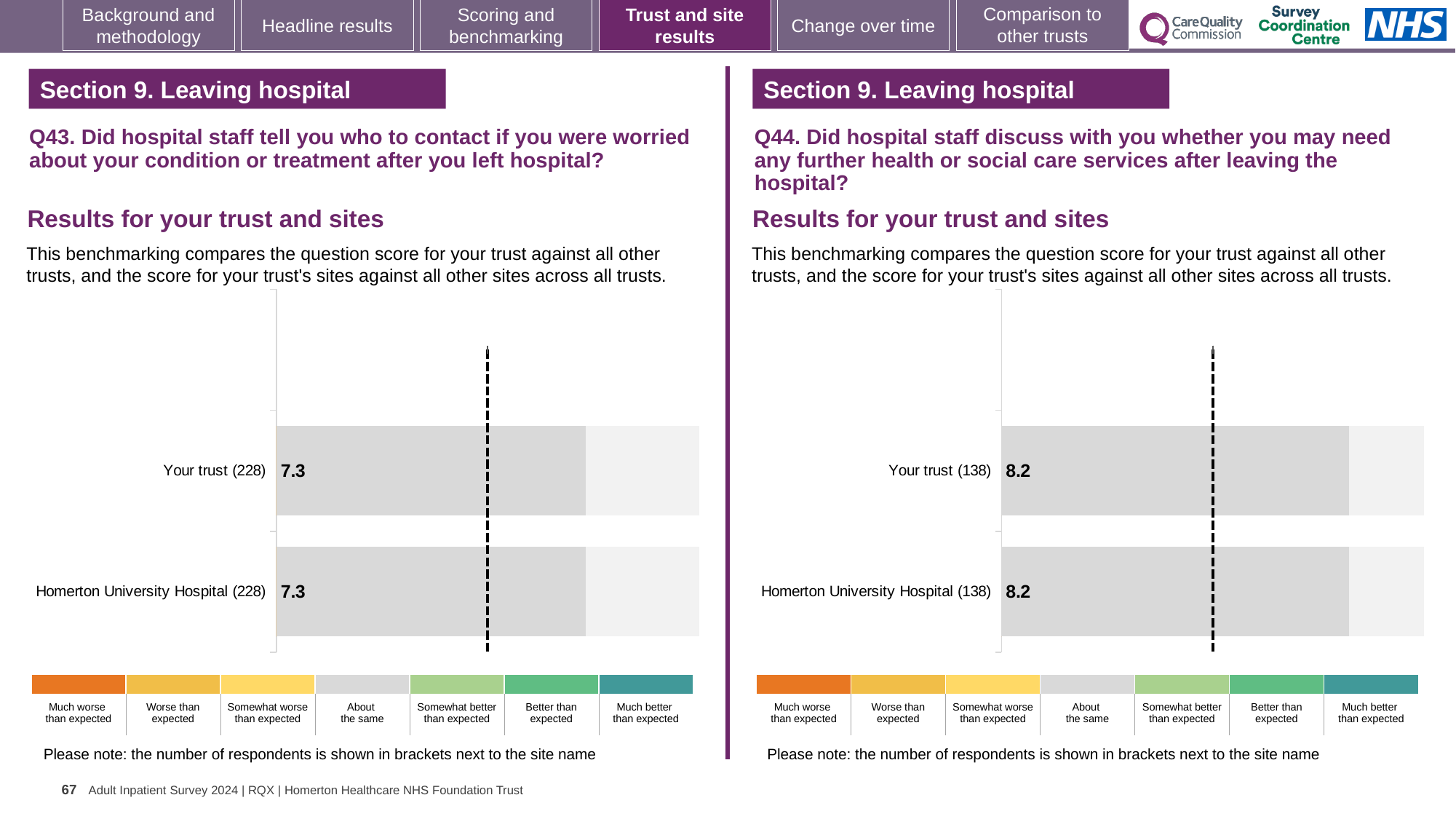
How many bars are plotted in the Q43 chart on the left? 2 In the Q43 chart on the left, how many respondents are shown in brackets for Your trust? 228 What is the label of the middle category in the colour key below the Q44 chart on the right? About the same In the Q44 chart on the right, what is the score for Your trust? 8.2 In the Q43 chart on the left, what is the score for Homerton University Hospital? 7.3 In the Q43 chart on the left, what is the difference between the score for Your trust and the score for Homerton University Hospital? 0 In the Q44 chart on the right, how many respondents are shown in brackets for Homerton University Hospital? 138 In the Q43 chart on the left, what is the score for Your trust? 7.3 In the Q44 chart on the right, what is the score for Homerton University Hospital? 8.2 What kind of chart is used for the Q44 results on the right? Bar chart Which is larger: the Your trust score in the Q43 chart on the left or the Your trust score in the Q44 chart on the right? Q44 chart (8.2) How many rating categories are shown in the colour key below the Q43 chart on the left? 7